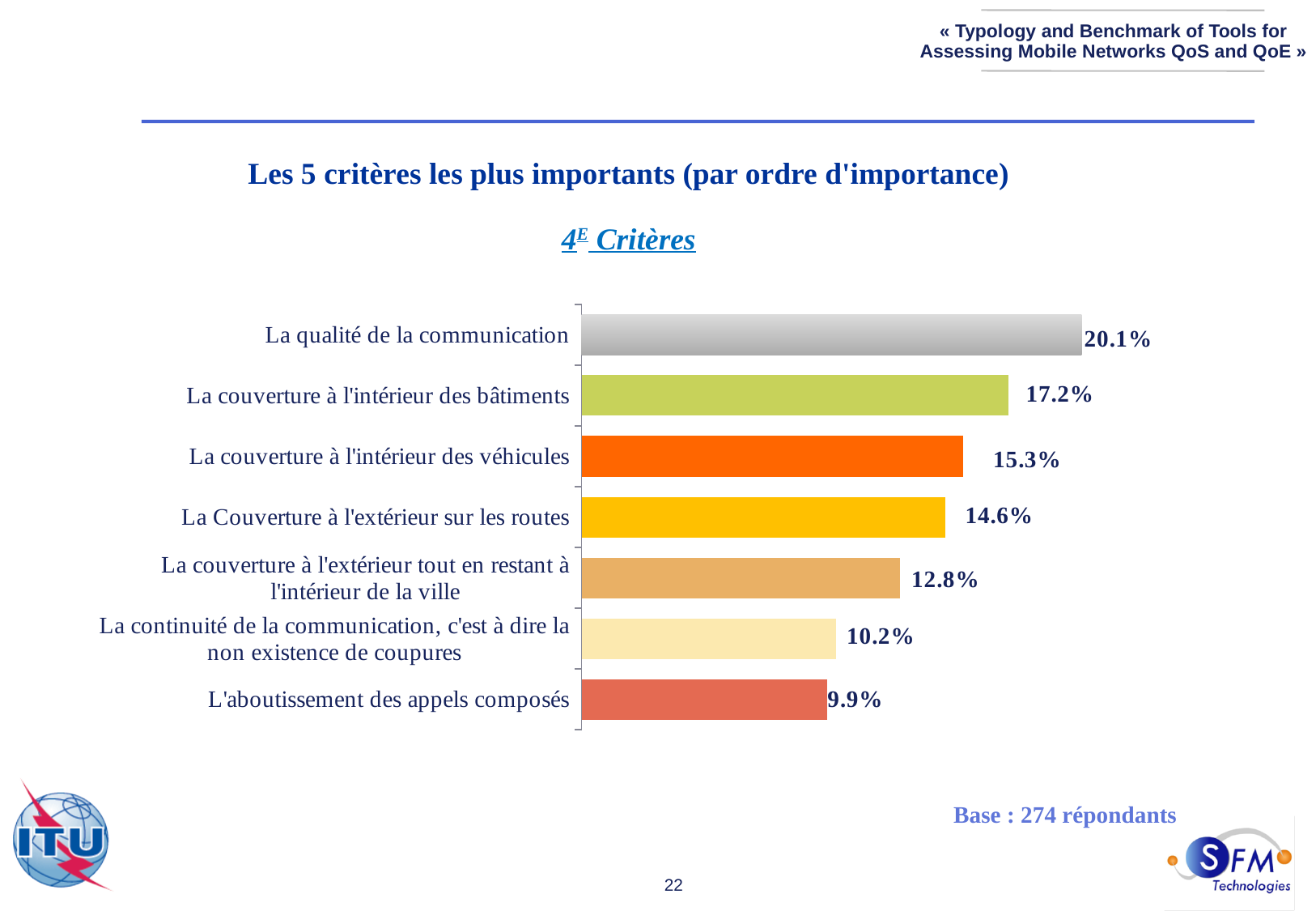
What is the value for "La couverture à l'intérieur des véhicules"? 15.3% Which is larger: the value for "La couverture à l'intérieur des bâtiments" or the value for "La couverture à l'intérieur des véhicules"? La couverture à l'intérieur des bâtiments How many categories are shown in the chart? 7 What kind of chart is shown on the slide? Bar chart What is the difference between the values for "La qualité de la communication" and "La couverture à l'intérieur des bâtiments"? 2.9% What is the base (number of respondents) stated on the slide? 274 répondants Which category has the lowest value? L'aboutissement des appels composés What is the value for "La continuité de la communication, c'est à dire la non existence de coupures"? 10.2% What is the value for "La qualité de la communication"? 20.1% What is the difference between the values for "La Couverture à l'extérieur sur les routes" and "La couverture à l'extérieur tout en restant à l'intérieur de la ville"? 1.8% What is the value for "L'aboutissement des appels composés"? 9.9% Which category has the highest value? La qualité de la communication